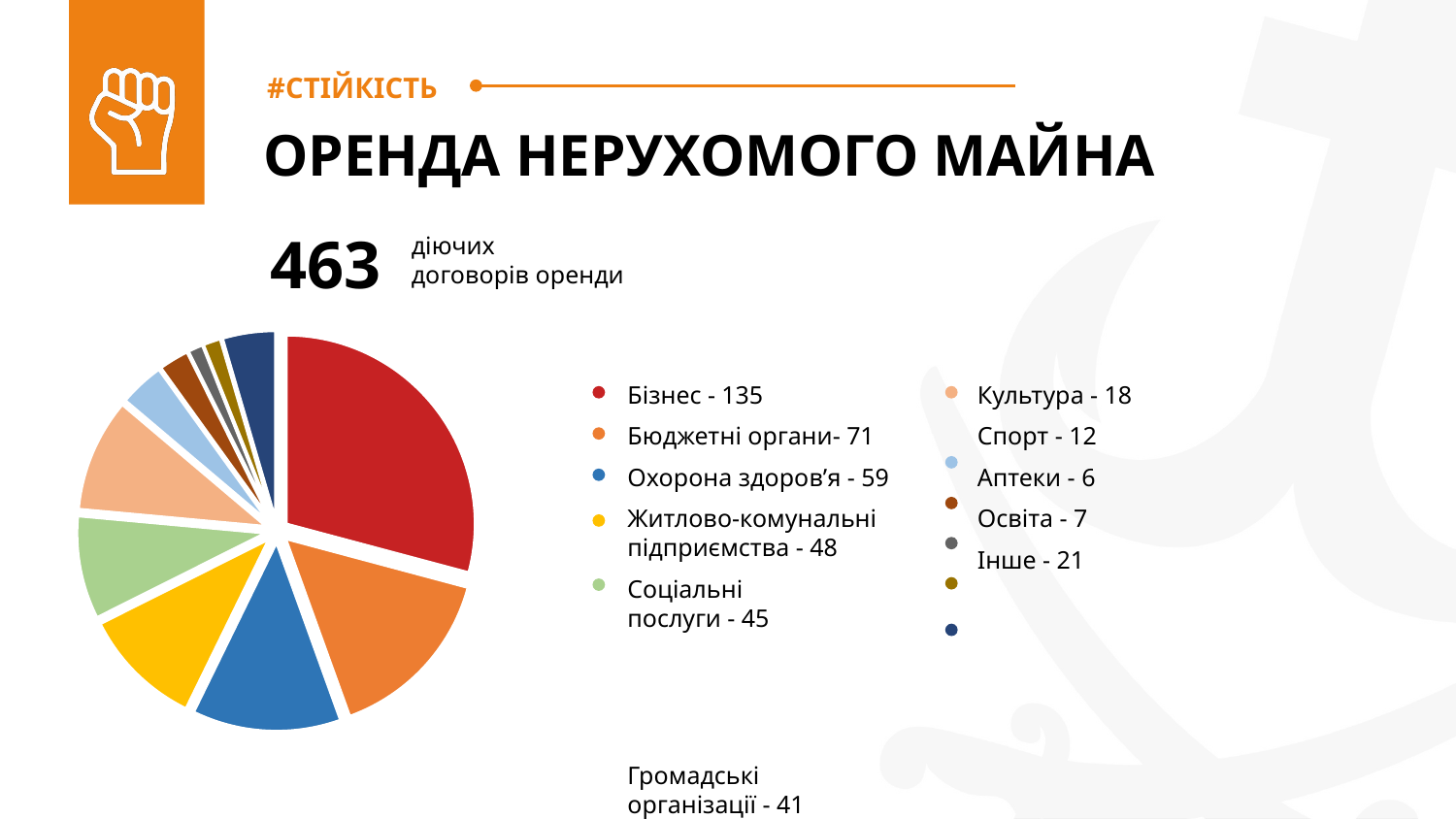
How many lease agreements are attributed to Охорона здоров'я? 59 What type of chart is shown on the slide? pie chart How many lease agreements are attributed to Бізнес? 135 Which has more lease agreements: Житлово-комунальні підприємства or Соціальні послуги? Житлово-комунальні підприємства What is the difference between the number of agreements for Культура and for Спорт? 6 How many categories are listed in the legend of the pie chart? 11 What is the difference between the number of agreements for Бізнес and for Бюджетні органи? 64 How many lease agreements are attributed to Громадські організації? 41 How many active lease agreements (діючих договорів оренди) does the slide report in total? 463 How many lease agreements are attributed to Бюджетні органи? 71 Which category has the smallest number of lease agreements? Аптеки Which category has the largest number of lease agreements? Бізнес